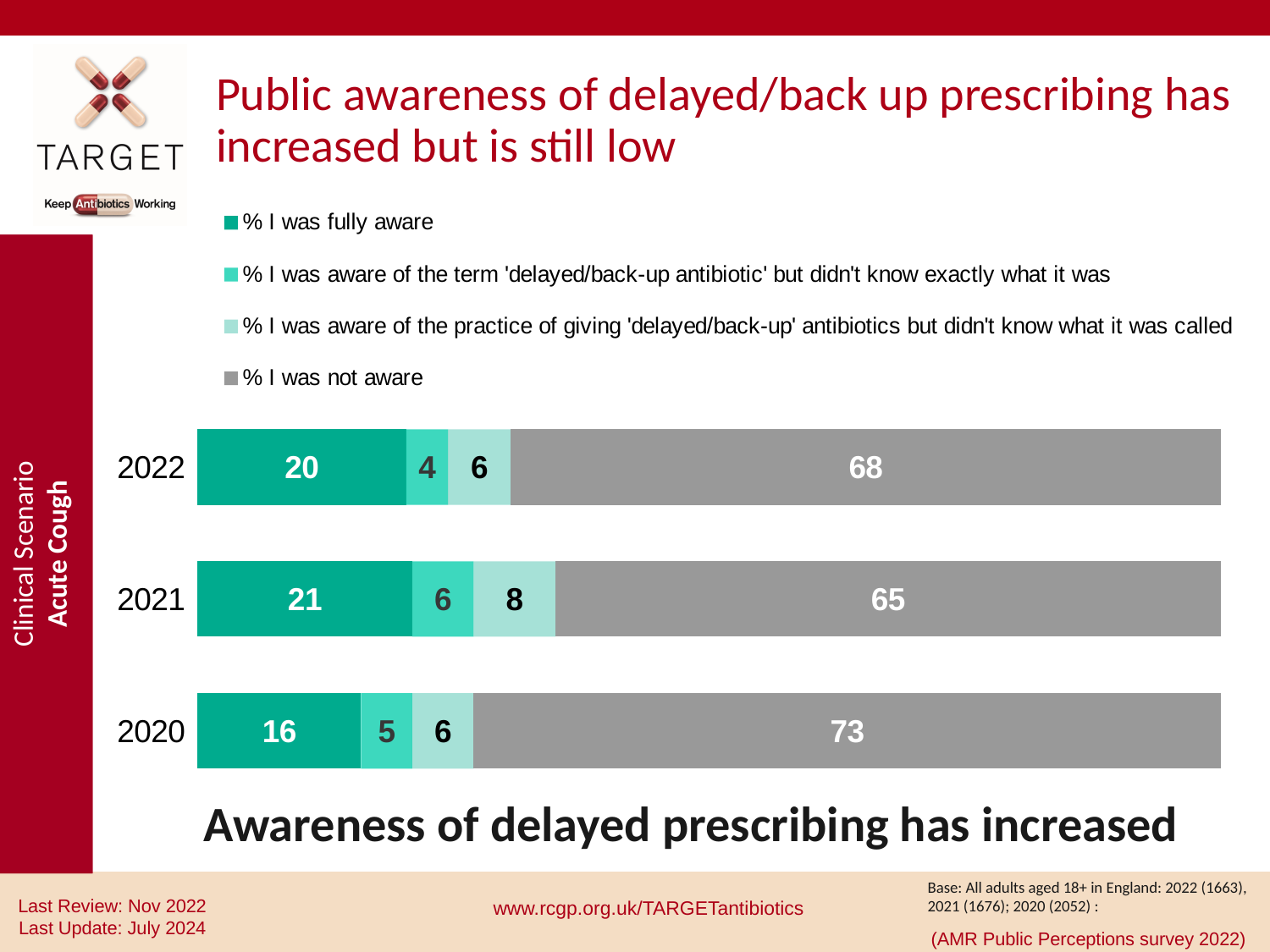
What is the value for '% I was not aware' in 2020? 73 How many years (categories) are plotted in the chart? 3 Which series is shown in grey in the chart? % I was not aware What is the value for '% I was aware of the practice of giving 'delayed/back-up' antibiotics but didn't know what it was called' in 2021? 8 What kind of chart is shown on the slide? Stacked bar chart Is the '% I was fully aware' value larger in 2021 or in 2020? 2021 What is the total of the stacked bar for 2021? 100 Which year has the lowest value for '% I was fully aware'? 2020 How many series does the legend list? 4 What is the difference between the '% I was not aware' values for 2020 and 2021? 8 What is the value for '% I was fully aware' in 2022? 20 Which year has the highest value for '% I was not aware'? 2020